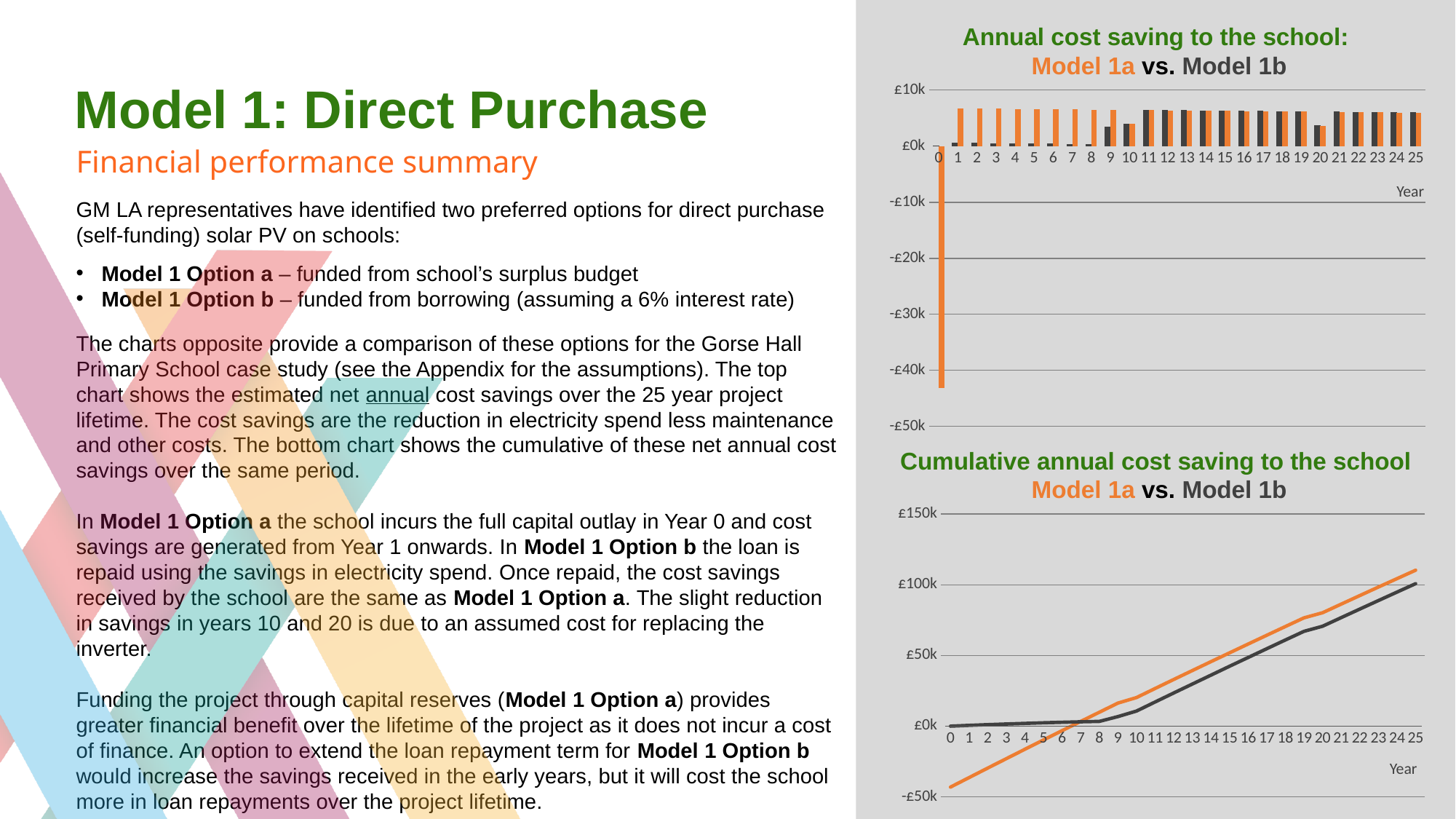
In the top chart, which year has the lowest value for Model 1a? Year 0 In the bottom chart, what colour is the line for Model 1a? Orange What kind of chart is the bottom chart, 'Cumulative annual cost saving to the school Model 1a vs. Model 1b'? Line chart In the bottom chart, does the Model 1a line rise or fall from year 0 to year 25? Rise In the top chart, is the value for Model 1a in year 0 greater or less than -£30k? less In the top chart, which is larger in year 5: Model 1a or Model 1b? Model 1a In the bottom chart, which is larger in year 25: Model 1a or Model 1b? Model 1a In the bottom chart, is the value for Model 1a in year 25 greater or less than £100k? greater In the top chart, is the value for Model 1a in year 5 greater or less than £0k? greater What kind of chart is the top chart, 'Annual cost saving to the school: Model 1a vs. Model 1b'? Bar chart In the top chart, how many years are shown on the x axis? 26